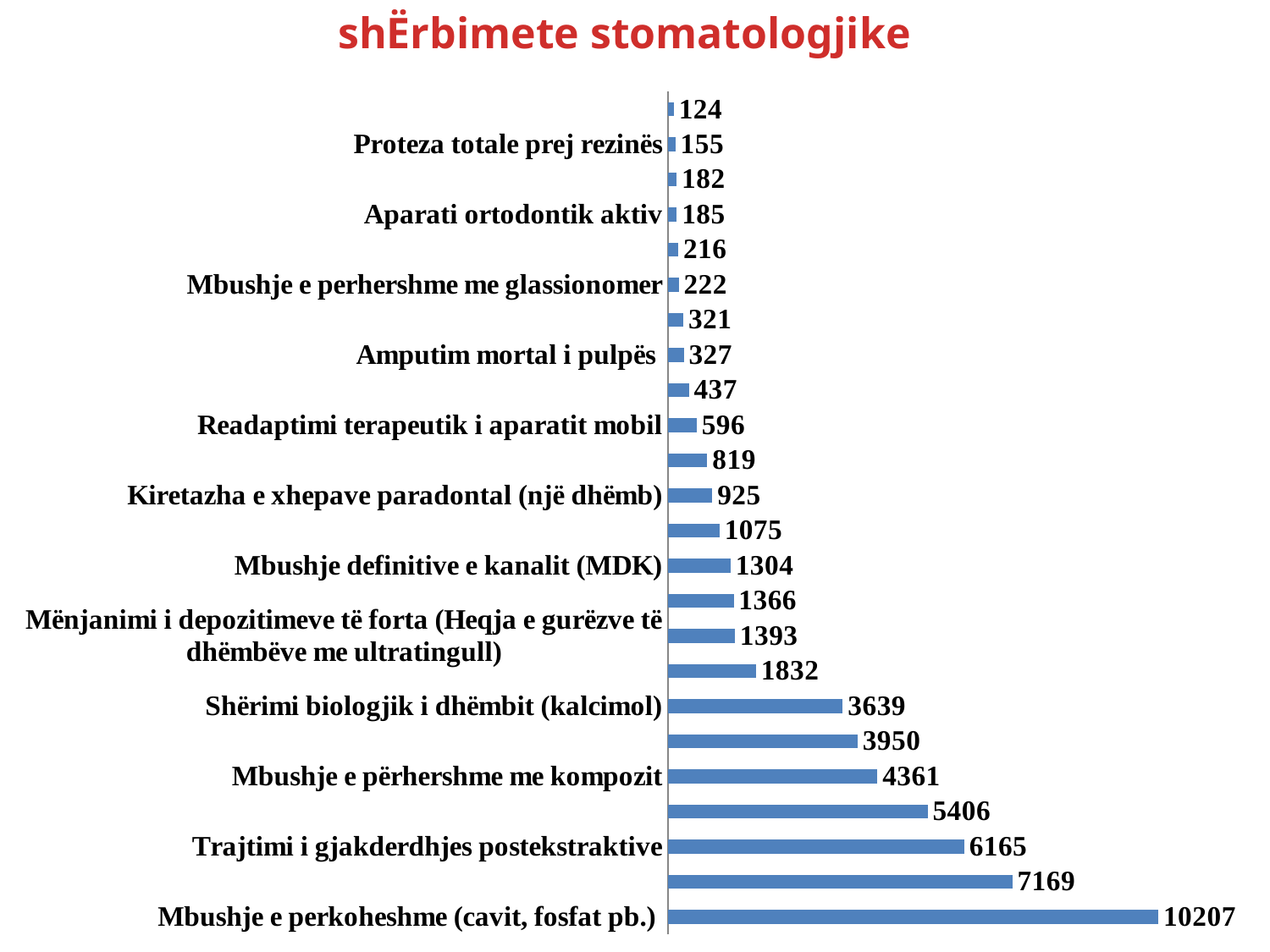
What type of chart is shown on the slide? bar chart What is the value for Mbushje e përhershme me kompozit? 4361 What is the value for Trajtimi i gjakderdhjes postekstraktive? 6165 What is the title of the chart? shËrbimete stomatologjike What is the value for Kiretazha e xhepave paradontal (një dhëmb)? 925 What is the difference between Mbushje e perkoheshme (cavit, fosfat pb.) and Trajtimi i gjakderdhjes postekstraktive? 4042 What is the smallest value shown on the chart? 124 Which is larger, Shërimi biologjik i dhëmbit (kalcimol) or Mbushje e përhershme me kompozit? Mbushje e përhershme me kompozit What is the value for Mbushje e perkoheshme (cavit, fosfat pb.)? 10207 What is the value for Aparati ortodontik aktiv? 185 How many bars are plotted on the chart? 24 Which category has the highest value? Mbushje e perkoheshme (cavit, fosfat pb.)